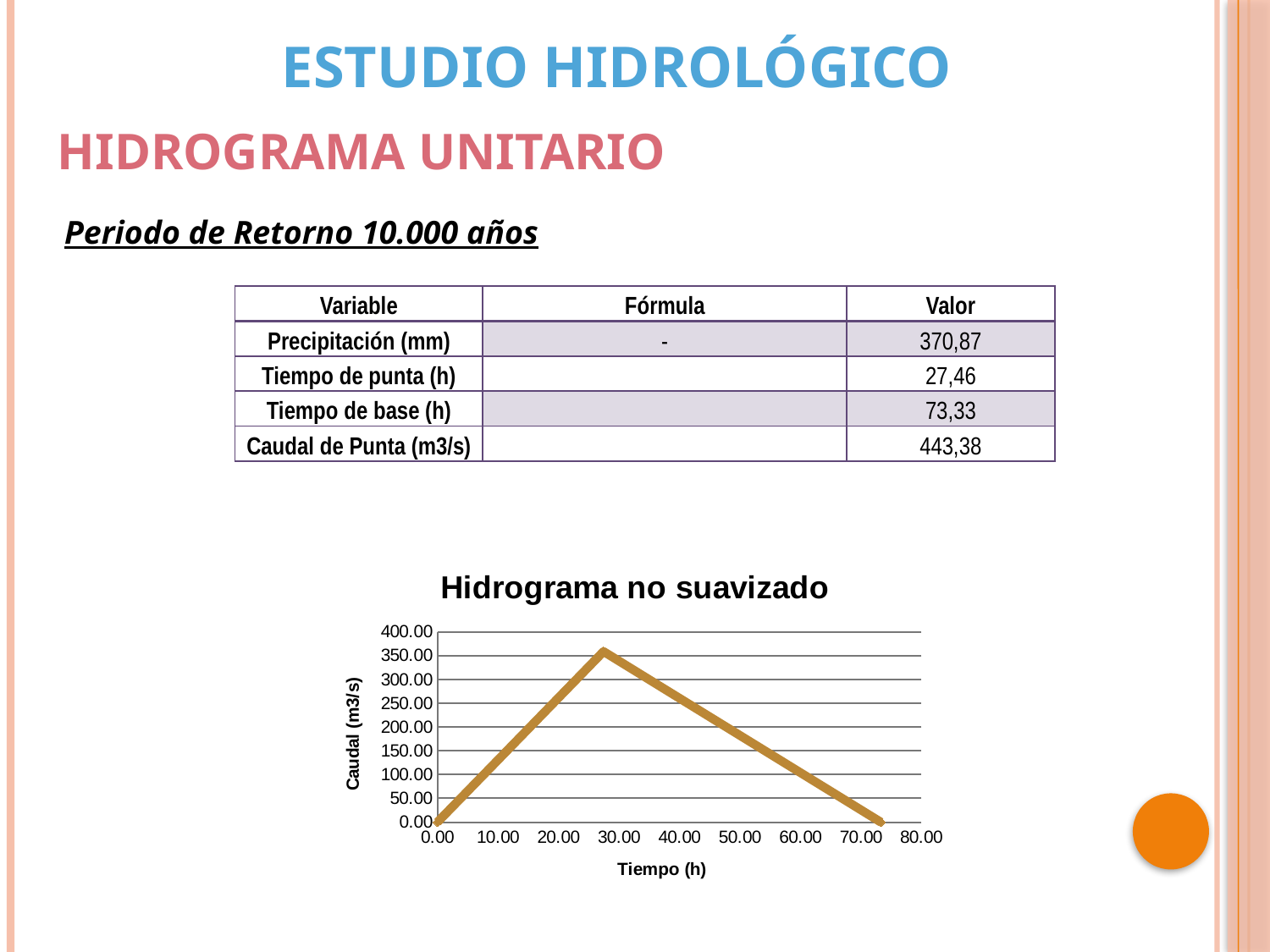
What is the Caudal value at Tiempo 0.00 in the chart? 0.00 Does the line in the chart rise or fall between Tiempo 40.00 and 70.00? fall Is the peak value of the line in the chart greater or less than 300.00? greater What is the label of the vertical axis of the chart? Caudal (m3/s) Is the Caudal value at Tiempo 10.00 greater or less than 50.00? greater What is the highest tick value shown on the vertical axis of the chart? 400.00 How many vertices (data points) does the line in the chart have? 3 What is the title of the chart on the slide? Hidrograma no suavizado Is the peak value of the line in the chart greater or less than 400.00? less What kind of chart is shown under the title "Hidrograma no suavizado"? line chart Does the line in the chart rise or fall between Tiempo 0.00 and 20.00? rise